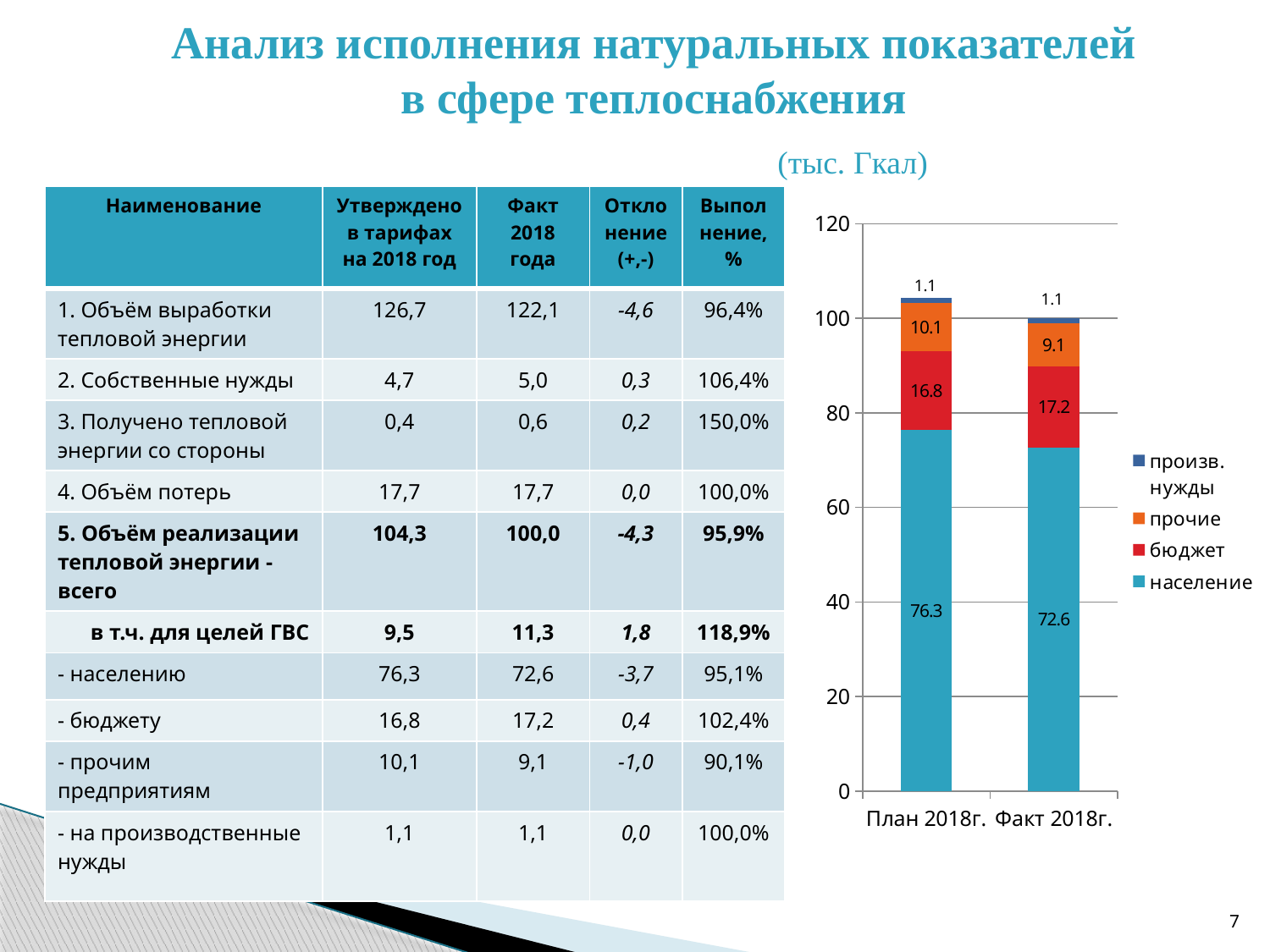
What is the difference between the население values for План 2018г. and Факт 2018г.? 3.7 What is the value of the прочие segment for План 2018г.? 10.1 Which series is shown in red in the chart legend? бюджет What is the value of the бюджет segment for Факт 2018г.? 17.2 What is the value of the население segment for План 2018г.? 76.3 What is the total of the stacked bar for Факт 2018г.? 100.0 What is the value of the произв. нужды segment for Факт 2018г.? 1.1 What is the total of the stacked bar for План 2018г.? 104.3 How many series does the chart legend list? 4 Which bar has the larger бюджет segment, План 2018г. or Факт 2018г.? Факт 2018г. How many bars (categories) does the chart show? 2 What type of chart is shown on the slide? stacked bar chart